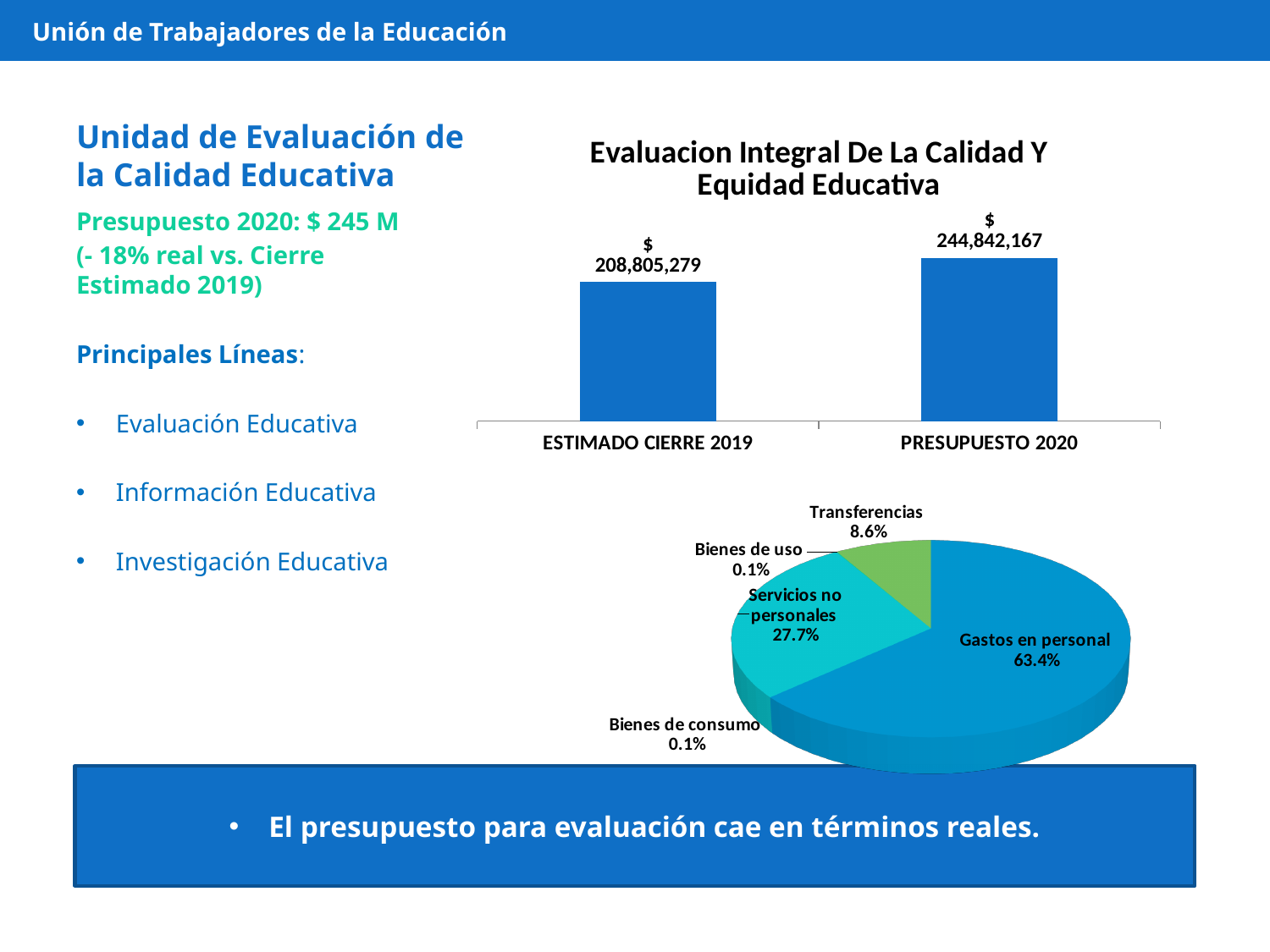
In the pie chart at the bottom right of the slide, what share does Servicios no personales have? 27.7% In the pie chart at the bottom right of the slide, how many slices are labelled? 5 In the bar chart titled 'Evaluacion Integral De La Calidad Y Equidad Educativa', do the values rise or fall from ESTIMADO CIERRE 2019 to PRESUPUESTO 2020? Rise In the pie chart at the bottom right of the slide, what share does Transferencias have? 8.6% In the pie chart at the bottom right of the slide, which slice is the largest? Gastos en personal In the bar chart titled 'Evaluacion Integral De La Calidad Y Equidad Educativa', what is the difference between PRESUPUESTO 2020 and ESTIMADO CIERRE 2019? $ 36,036,888 In the bar chart titled 'Evaluacion Integral De La Calidad Y Equidad Educativa', how many bars are plotted? 2 In the bar chart titled 'Evaluacion Integral De La Calidad Y Equidad Educativa', which category has the higher value? PRESUPUESTO 2020 In the bar chart titled 'Evaluacion Integral De La Calidad Y Equidad Educativa', what is the value for ESTIMADO CIERRE 2019? $ 208,805,279 In the pie chart at the bottom right of the slide, what share does Gastos en personal have? 63.4% What kind of chart is the upper chart titled 'Evaluacion Integral De La Calidad Y Equidad Educativa'? Bar chart In the bar chart titled 'Evaluacion Integral De La Calidad Y Equidad Educativa', what is the value for PRESUPUESTO 2020? $ 244,842,167